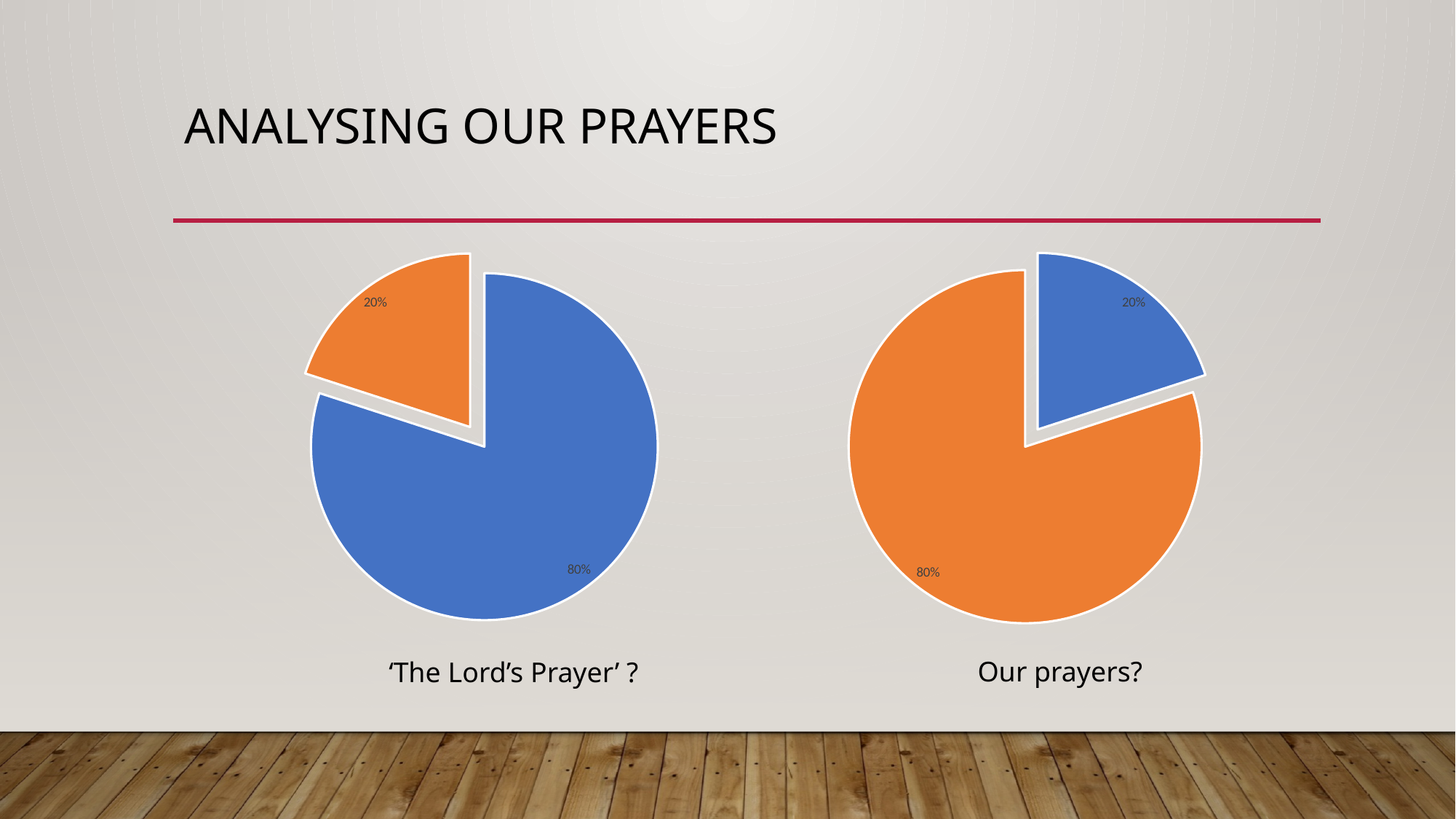
In the right pie chart (Our prayers?), what share does the orange slice have? 80% In the left pie chart ('The Lord's Prayer' ?), what share does the orange slice have? 20% In the right pie chart (Our prayers?), what share does the blue slice have? 20% What kind of chart is shown on the left of the slide, captioned 'The Lord's Prayer' ? pie chart In the left pie chart ('The Lord's Prayer' ?), what is the difference between the blue slice's share and the orange slice's share? 60% In the right pie chart (Our prayers?), which colour slice is the smallest? blue How many pie charts are on the slide? 2 How many slices does the right pie chart (Our prayers?) have? 2 What is the caption under the right pie chart? Our prayers? In the left pie chart ('The Lord's Prayer' ?), which colour slice is the largest? blue In the right pie chart (Our prayers?), which slice is larger, the orange one or the blue one? orange